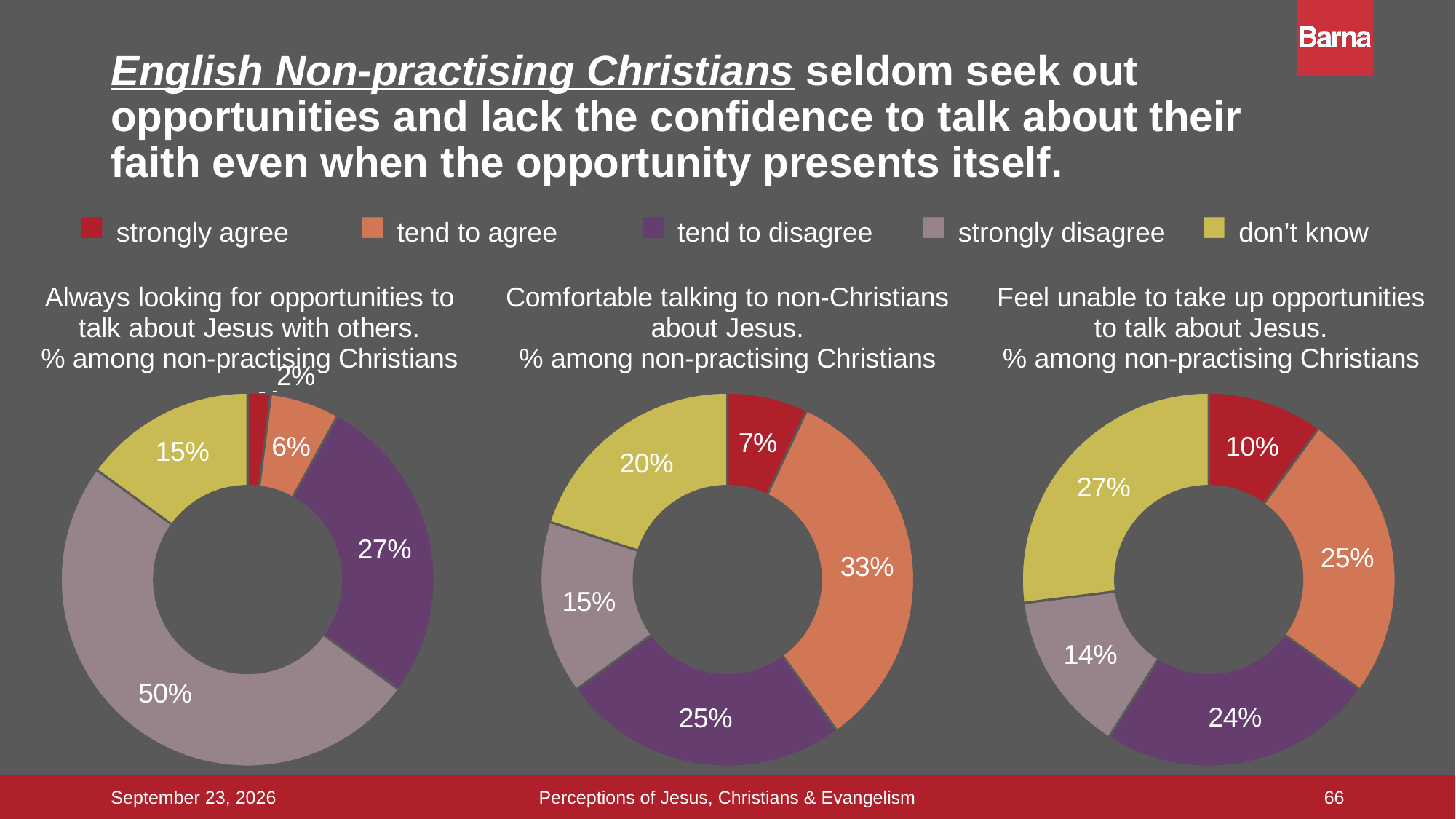
In the 'Feel unable to take up opportunities to talk about Jesus' chart, which response has the smallest share? strongly agree In the 'Comfortable talking to non-Christians about Jesus' chart, what percentage tend to agree? 33% In the 'Comfortable talking to non-Christians about Jesus' chart, which response has the largest share? tend to agree In the 'Feel unable to take up opportunities to talk about Jesus' chart, what percentage don't know? 27% In the 'Comfortable talking to non-Christians about Jesus' chart, which is larger: tend to disagree or don't know? tend to disagree In the 'Feel unable to take up opportunities to talk about Jesus' chart, what is the combined share of strongly agree and tend to agree? 35% In the 'Always looking for opportunities to talk about Jesus with others' chart, which response has the smallest share? strongly agree Which colour represents 'don't know' in the legend? Yellow In the 'Always looking for opportunities to talk about Jesus with others' chart, what is the difference between the strongly disagree and tend to disagree shares? 23% In the 'Always looking for opportunities to talk about Jesus with others' chart, what percentage strongly disagree? 50% What type of chart is used on this slide? Donut (pie) chart How many response categories does the legend list? 5